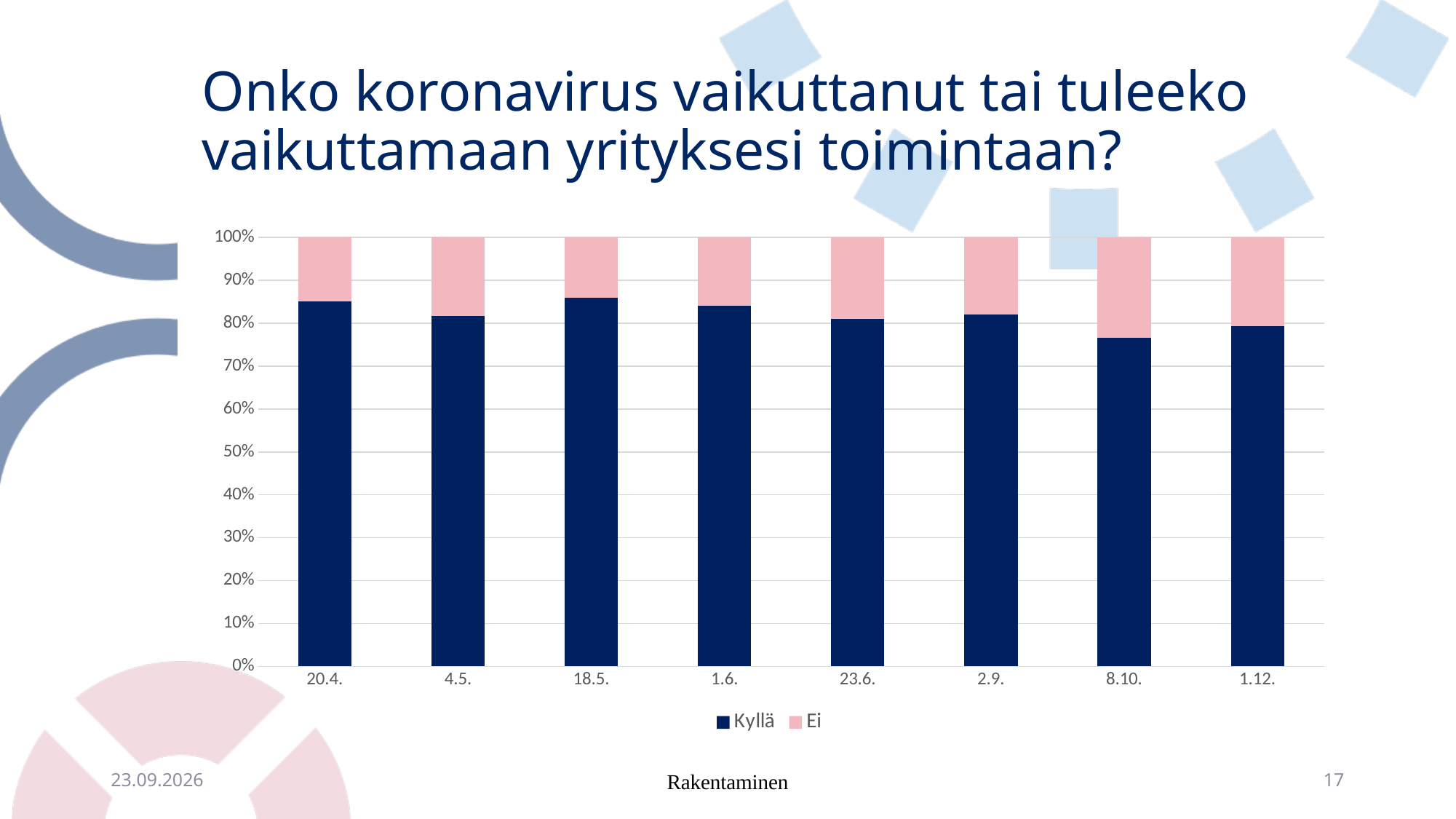
What kind of chart is shown on the slide? stacked bar chart Which series is shown in dark blue in the chart? Kyllä What are the two series named in the chart legend? Kyllä and Ei Is the Kyllä value for 8.10. greater or less than 80%? less Is the Ei value for 18.5. greater or less than 20%? less How many dates (categories) are shown on the x axis of the chart? 8 What is the total height of each stacked bar in the chart? 100% How many series does the chart legend list? 2 Which has the larger Kyllä share, 20.4. or 8.10.? 20.4. On which date is the Kyllä share the lowest? 8.10. Is the Ei value for 8.10. greater or less than 20%? greater